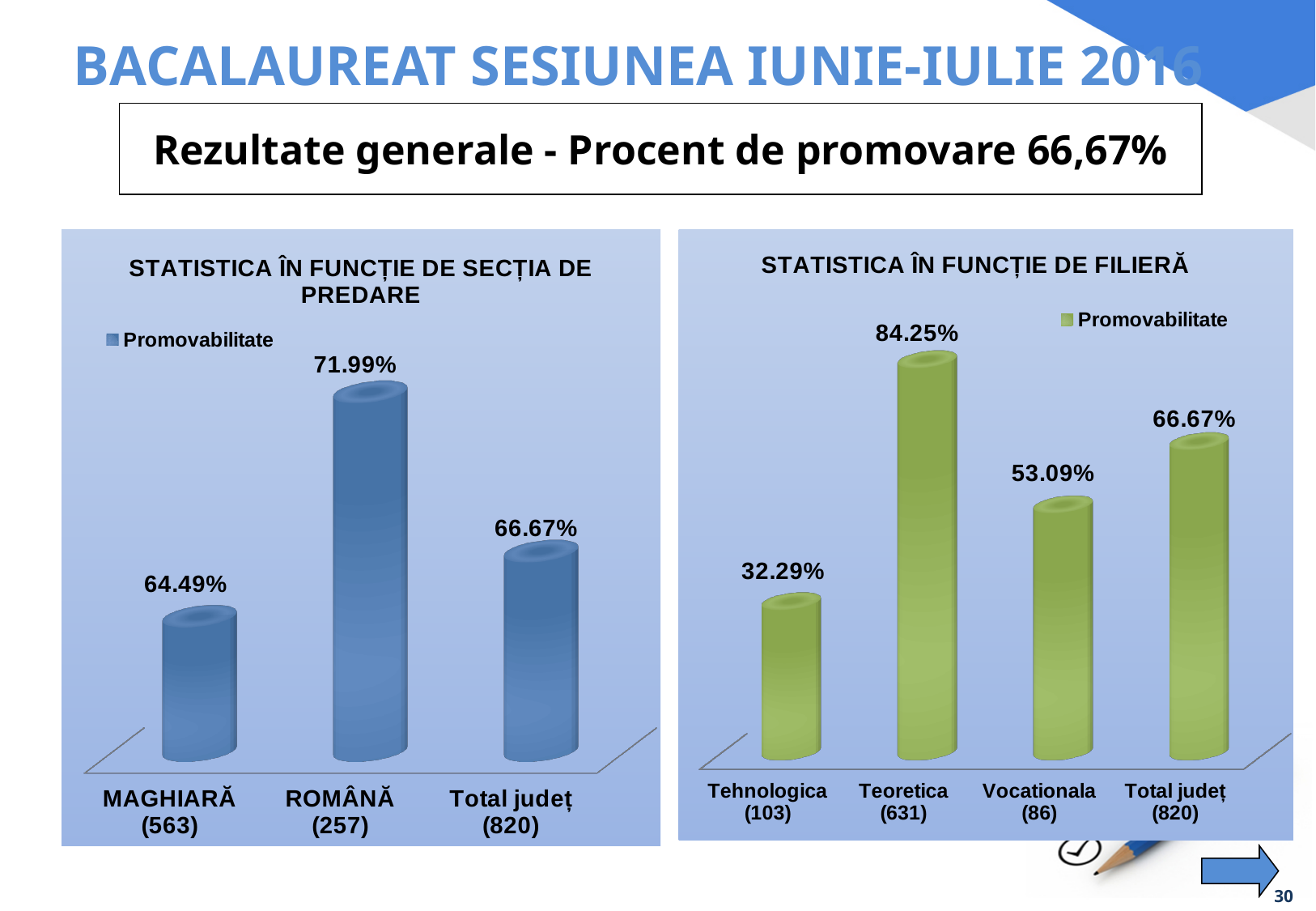
In the chart 'STATISTICA ÎN FUNCȚIE DE FILIERĂ', what is the difference between the values for Teoretica and Tehnologica? 51.96% In the chart 'STATISTICA ÎN FUNCȚIE DE FILIERĂ', what is the value for Vocationala (86)? 53.09% In the chart 'STATISTICA ÎN FUNCȚIE DE FILIERĂ', how many categories are shown? 4 In the chart 'STATISTICA ÎN FUNCȚIE DE SECȚIA DE PREDARE', how many categories are shown? 3 In the chart 'STATISTICA ÎN FUNCȚIE DE SECȚIA DE PREDARE', what is the Promovabilitate value for ROMÂNĂ (257)? 71.99% In the chart 'STATISTICA ÎN FUNCȚIE DE SECȚIA DE PREDARE', what is the value for MAGHIARĂ (563)? 64.49% In the chart 'STATISTICA ÎN FUNCȚIE DE SECȚIA DE PREDARE', what is the difference between the values for ROMÂNĂ and MAGHIARĂ? 7.5% In the chart 'STATISTICA ÎN FUNCȚIE DE FILIERĂ', which category has the lowest value? Tehnologica (103) In the chart 'STATISTICA ÎN FUNCȚIE DE FILIERĂ', which is larger, the value for Vocationala or the value for Total județ? Total județ In the chart 'STATISTICA ÎN FUNCȚIE DE SECȚIA DE PREDARE', which category has the highest value? ROMÂNĂ (257) In the chart 'STATISTICA ÎN FUNCȚIE DE FILIERĂ', what is the value for Teoretica (631)? 84.25% What kind of chart is 'STATISTICA ÎN FUNCȚIE DE FILIERĂ'? Bar chart